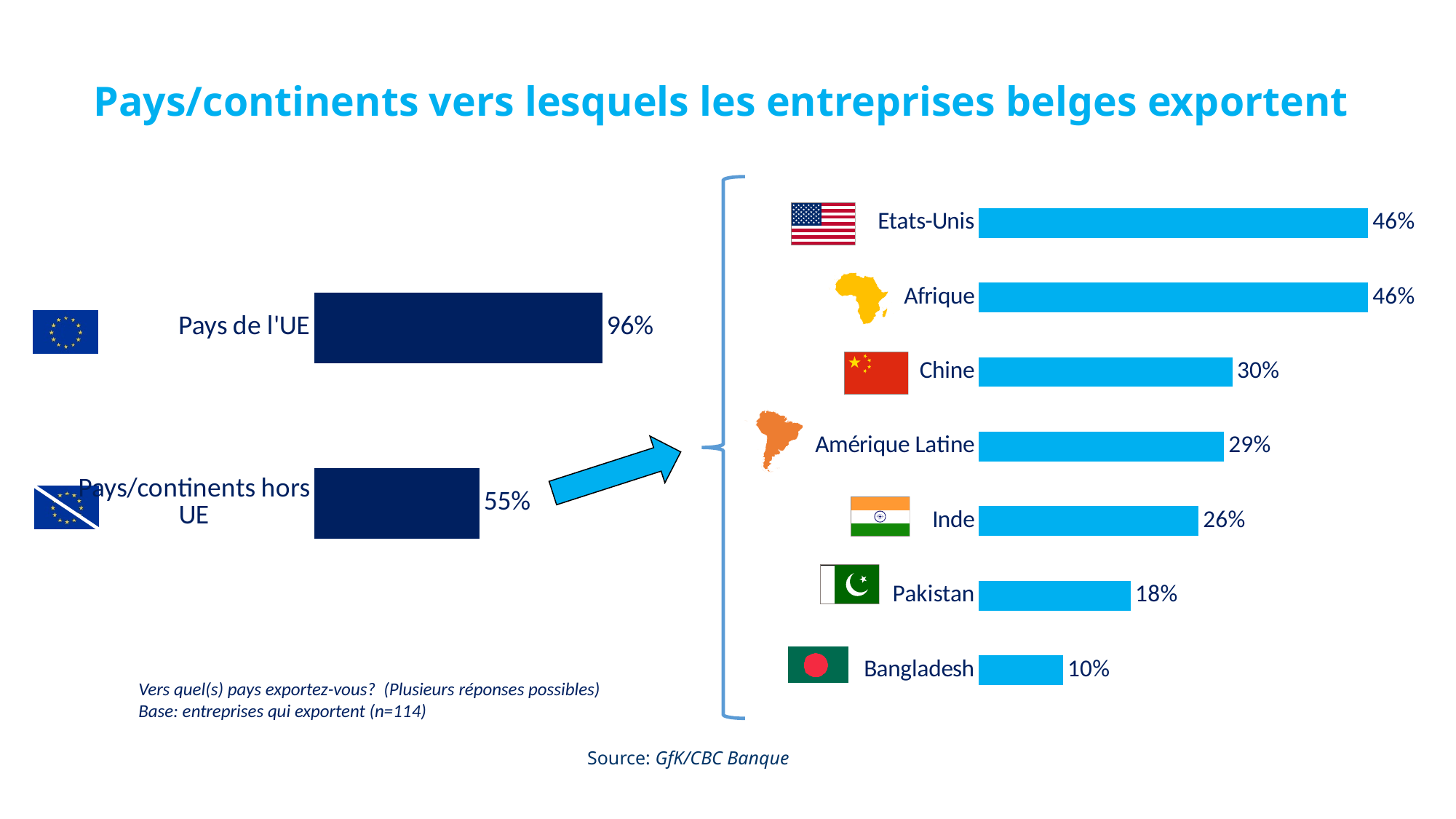
In the left chart, what is the value for Pays/continents hors UE? 55% In the right chart, how many categories are shown? 7 In the right chart, what is the difference between Etats-Unis and Bangladesh? 36% In the right chart, what is the value for Pakistan? 18% In the left chart, what is the value for Pays de l'UE? 96% In the right chart, which category has the lowest value? Bangladesh What kind of chart is the right chart? Bar chart What is the title of the slide? Pays/continents vers lesquels les entreprises belges exportent In the left chart, what is the difference between Pays de l'UE and Pays/continents hors UE? 41% In the right chart, which is larger, Chine or Inde? Chine In the right chart, what is the value for Inde? 26% In the right chart, what is the value for Chine? 30%